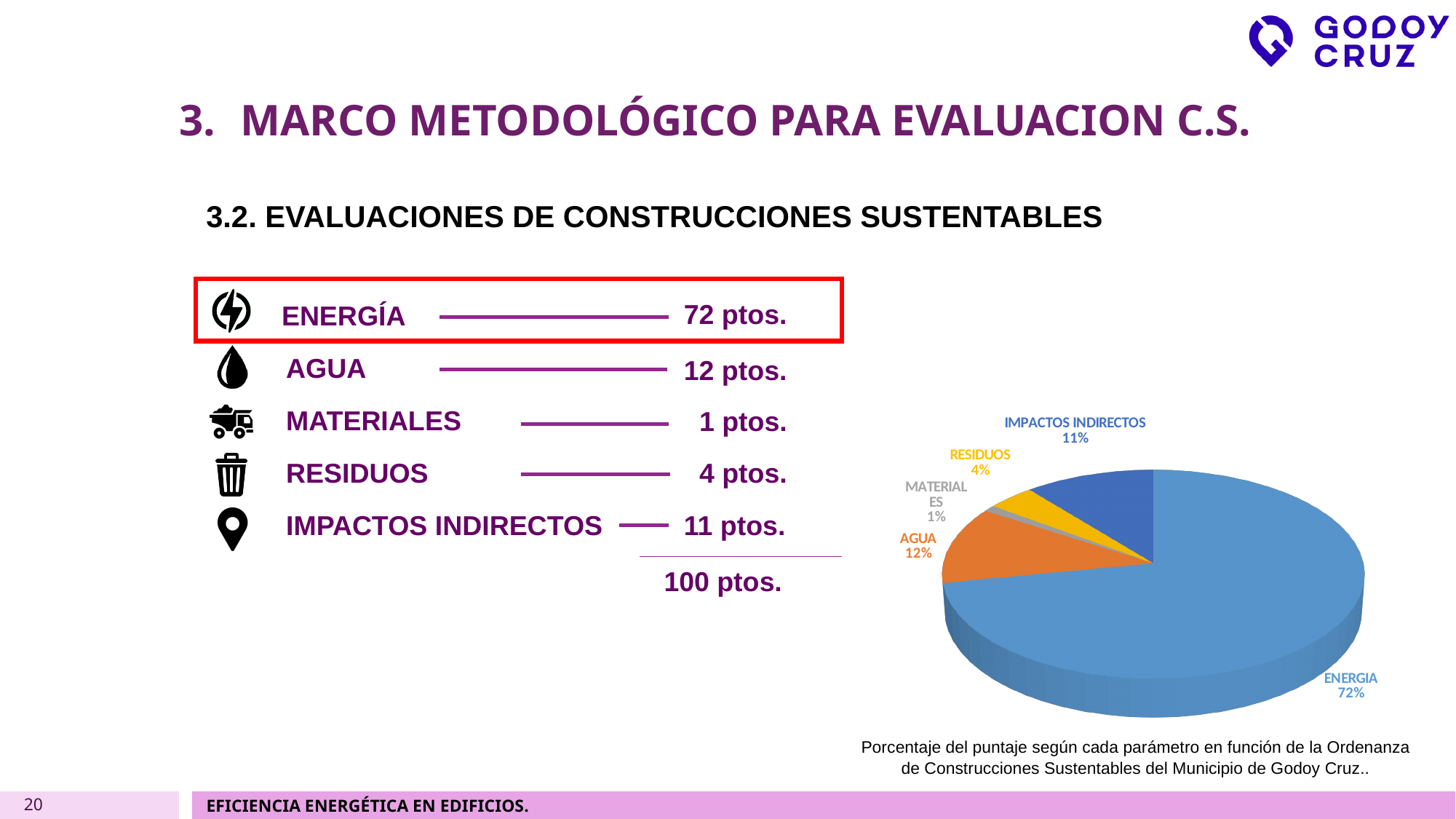
What colour is the ENERGIA slice in the pie chart? blue What percentage does the ENERGIA slice represent in the pie chart? 72% Which category has the smallest slice in the pie chart? MATERIALES What percentage does the RESIDUOS slice represent in the pie chart? 4% What kind of chart is shown on the slide? pie chart Which category has the largest slice in the pie chart? ENERGIA What percentage does the MATERIALES slice represent in the pie chart? 1% What percentage does the IMPACTOS INDIRECTOS slice represent in the pie chart? 11% What is the difference in percentage points between the ENERGIA slice and the AGUA slice? 60 Which slice is larger in the pie chart, RESIDUOS or IMPACTOS INDIRECTOS? IMPACTOS INDIRECTOS How many slices does the pie chart have? 5 What percentage does the AGUA slice represent in the pie chart? 12%